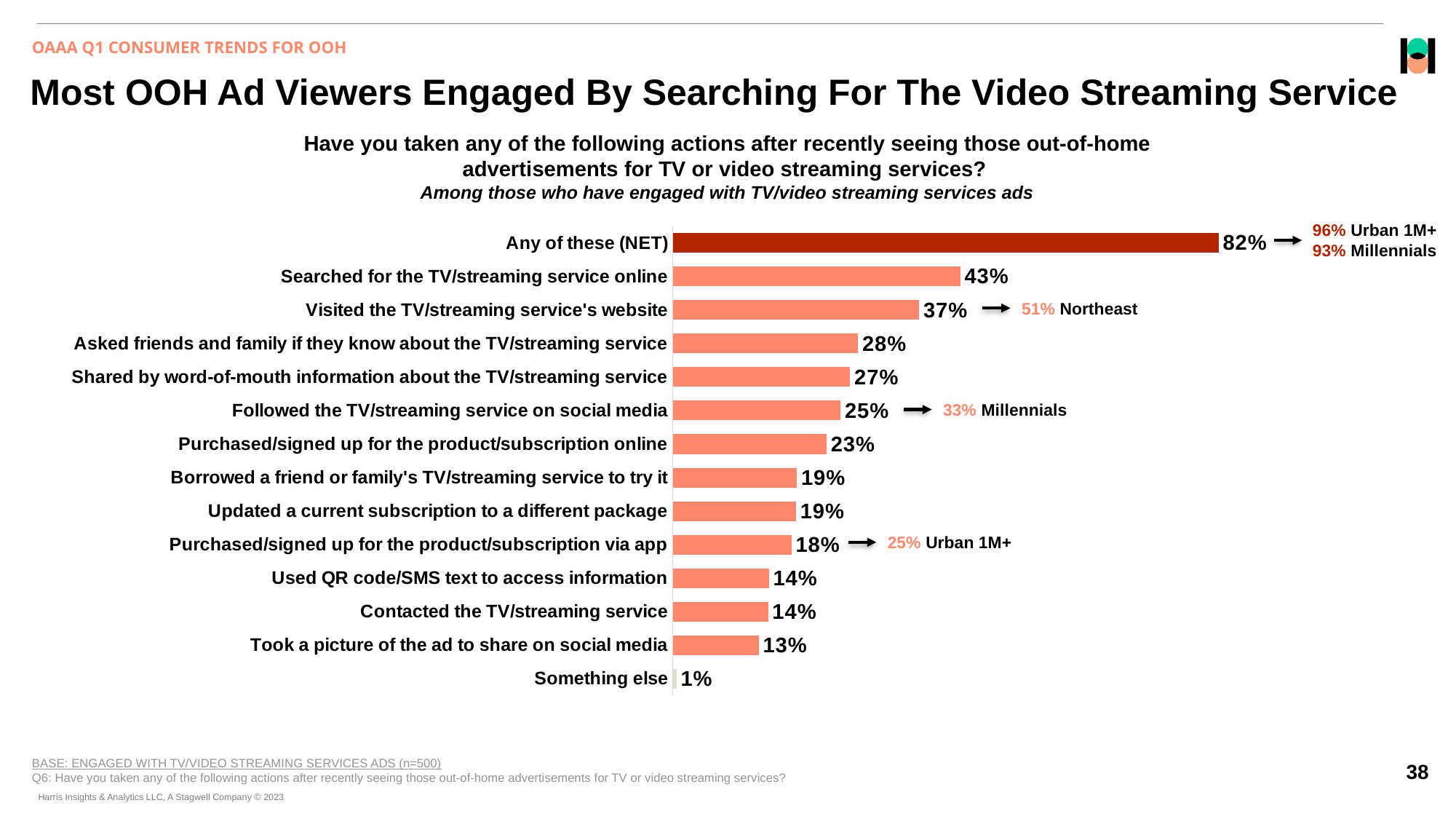
What percentage took a picture of the ad to share on social media? 13% Which is larger: 'Purchased/signed up for the product/subscription online' or 'Purchased/signed up for the product/subscription via app'? Purchased/signed up for the product/subscription online What percentage of respondents searched for the TV/streaming service online? 43% How many categories (bars) are shown in the chart? 14 What kind of chart is shown on the slide? Bar chart What percentage followed the TV/streaming service on social media? 25% What is the value for 'Any of these (NET)'? 82% Which category has the lowest percentage? Something else What percentage of Millennials followed the TV/streaming service on social media, according to the callout? 33% What percentage of Urban 1M+ respondents took any of these actions (NET), according to the callout? 96% What is the difference between 'Searched for the TV/streaming service online' and 'Visited the TV/streaming service's website'? 6% Excluding the NET bar, which action has the highest percentage? Searched for the TV/streaming service online